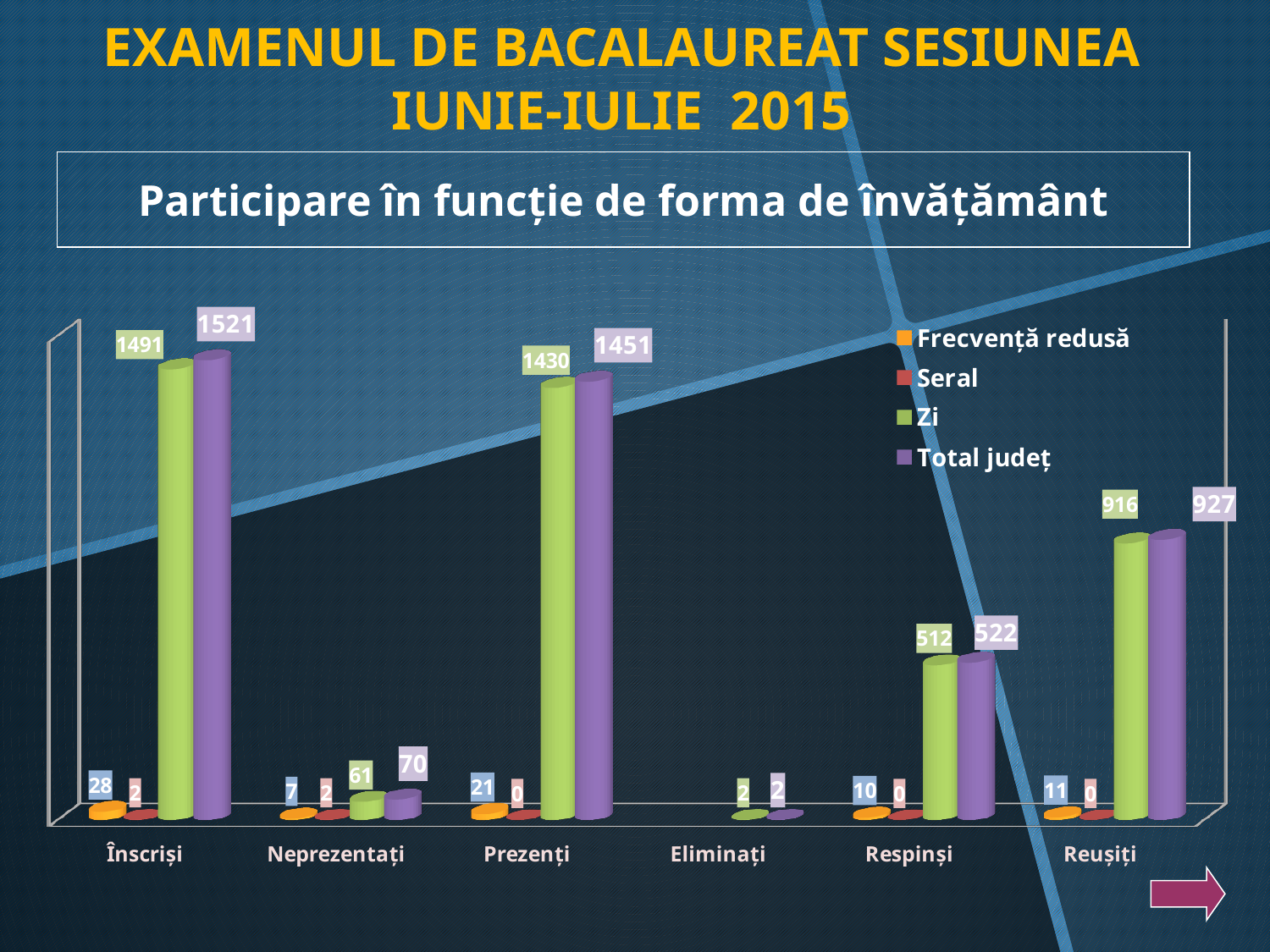
How many categories are shown on the x axis? 6 Which category has the lowest Total județ value? Eliminați What is the value of Zi for Respinși? 512 What kind of chart is shown on the slide? Bar chart Which category has the highest Total județ value? Înscriși What is the difference between the Total județ value and the Zi value for Înscriși? 30 What is the value of Frecvență redusă for Înscriși? 28 How many series does the legend list? 4 Which is larger, the Zi value for Respinși or the Zi value for Reușiți? Reușiți What is the value of Total județ for Înscriși? 1521 What is the value of Zi for Prezenți? 1430 What is the value of Total județ for Reușiți? 927